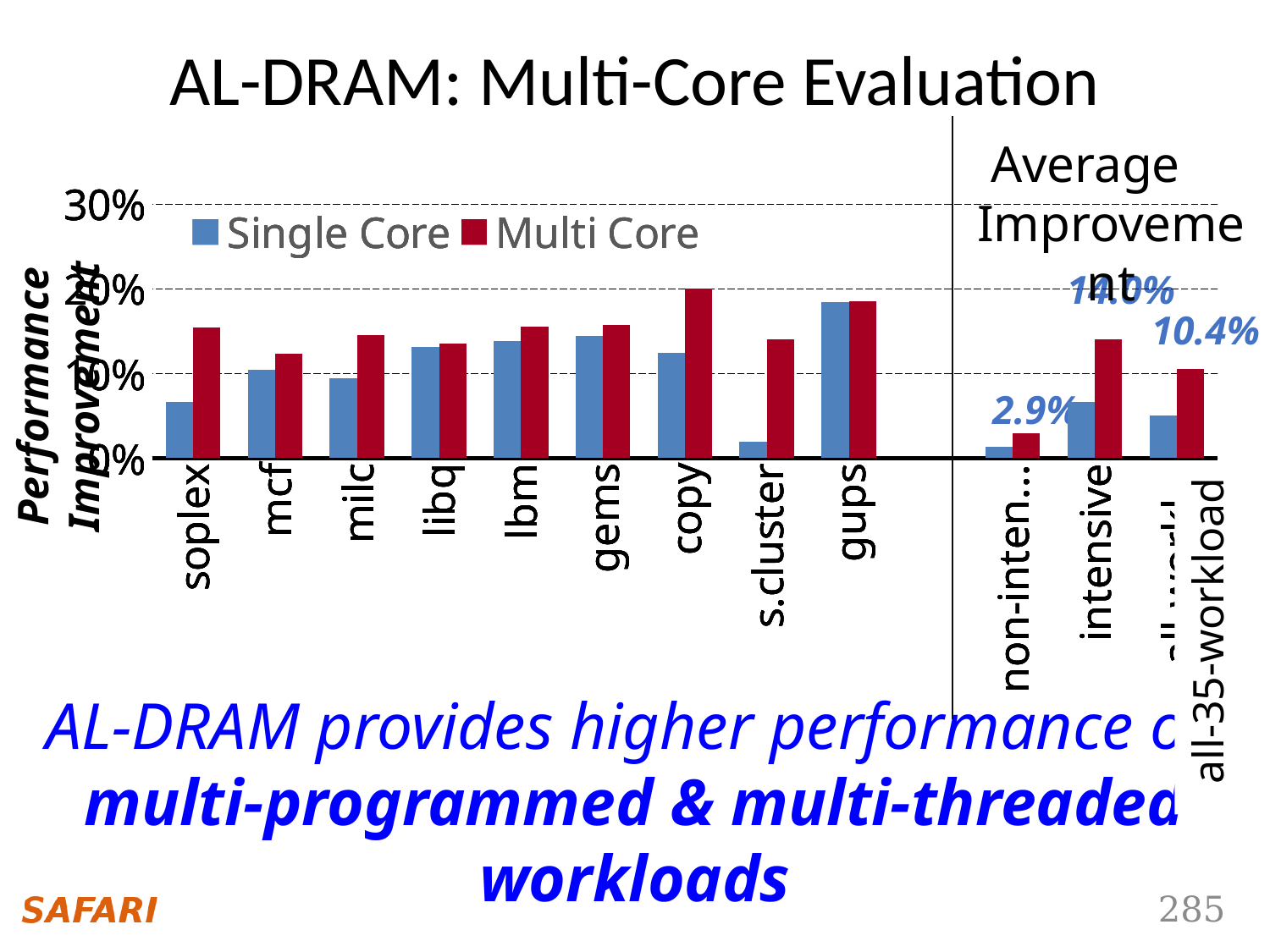
Is the Multi Core value for gups greater or less than 10%? greater What is the Multi Core average improvement labelled for all-35-workload? 10.4% What are the two series named in the legend? Single Core and Multi Core How many series does the legend list? 2 Is the Single Core value for s.cluster greater or less than 10%? less Which benchmark has the highest Single Core performance improvement? gups Which benchmark has the lowest Single Core performance improvement? s.cluster What kind of chart is shown on the slide? bar chart For soplex, which is larger: the Single Core or the Multi Core value? Multi Core How many categories are shown along the x axis? 12 What is the Multi Core average improvement labelled for the non-intensive workloads? 2.9% Which colour represents the Multi Core series? red